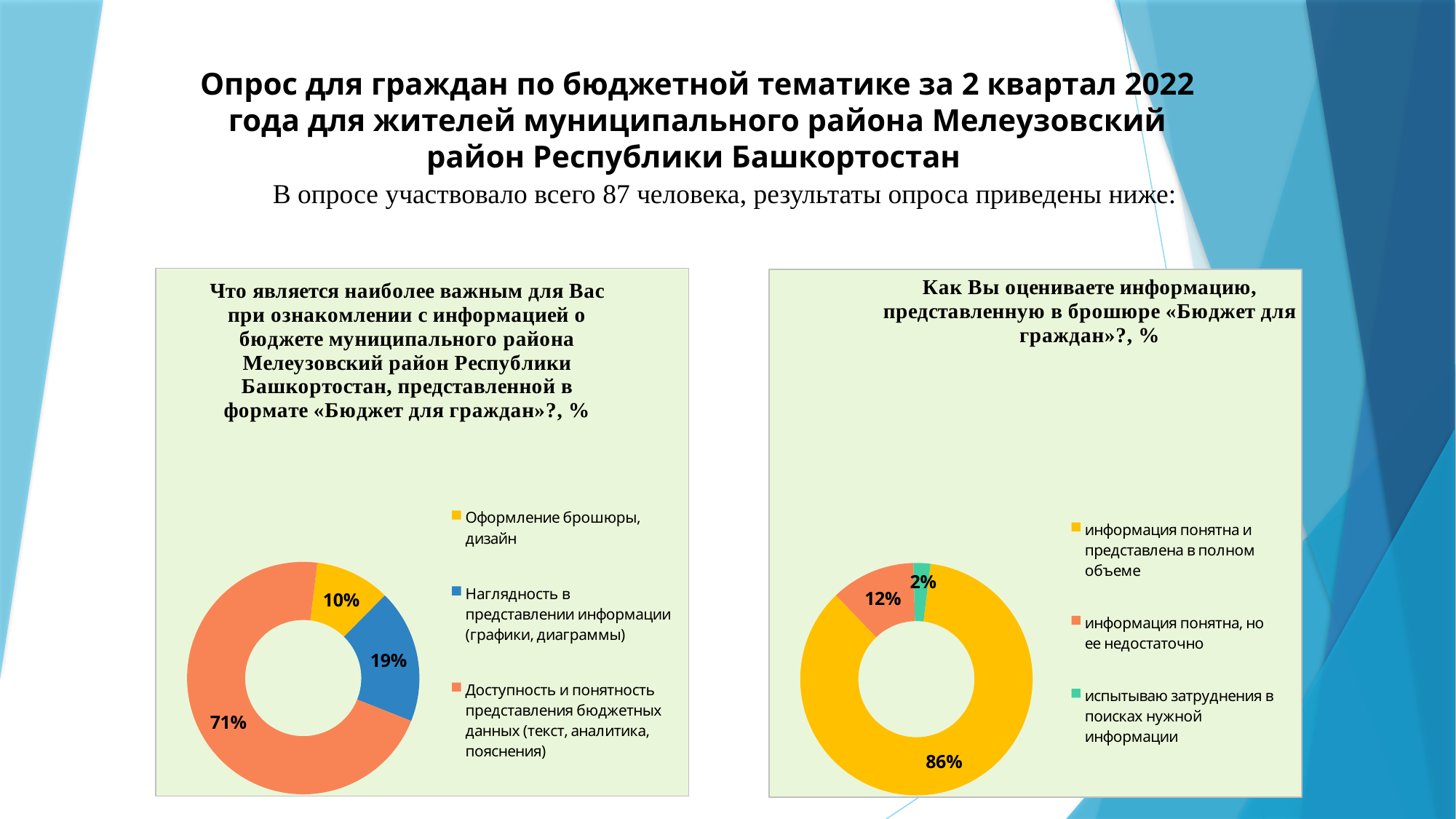
In the right chart, what colour is the slice for «информация понятна, но ее недостаточно»? Orange How many categories does the legend of the left chart list? 3 In the left chart, which category has the smallest share? Оформление брошюры, дизайн In the left chart, what share of respondents chose «Доступность и понятность представления бюджетных данных (текст, аналитика, пояснения)»? 71% What type of chart is the left chart? Doughnut chart In the right chart, what share of respondents answered «информация понятна и представлена в полном объеме»? 86% In the left chart, what is the value for «Наглядность в представлении информации (графики, диаграммы)»? 19% In the left chart, what is the difference between the shares for «Доступность и понятность представления бюджетных данных» and «Наглядность в представлении информации»? 52% In the right chart, what is the difference between the shares for «информация понятна и представлена в полном объеме» and «информация понятна, но ее недостаточно»? 74% In the right chart, what is the value for «испытываю затруднения в поисках нужной информации»? 2% In the right chart, which is larger: «информация понятна, но ее недостаточно» or «испытываю затруднения в поисках нужной информации»? информация понятна, но ее недостаточно In the right chart, which category has the largest share? информация понятна и представлена в полном объеме